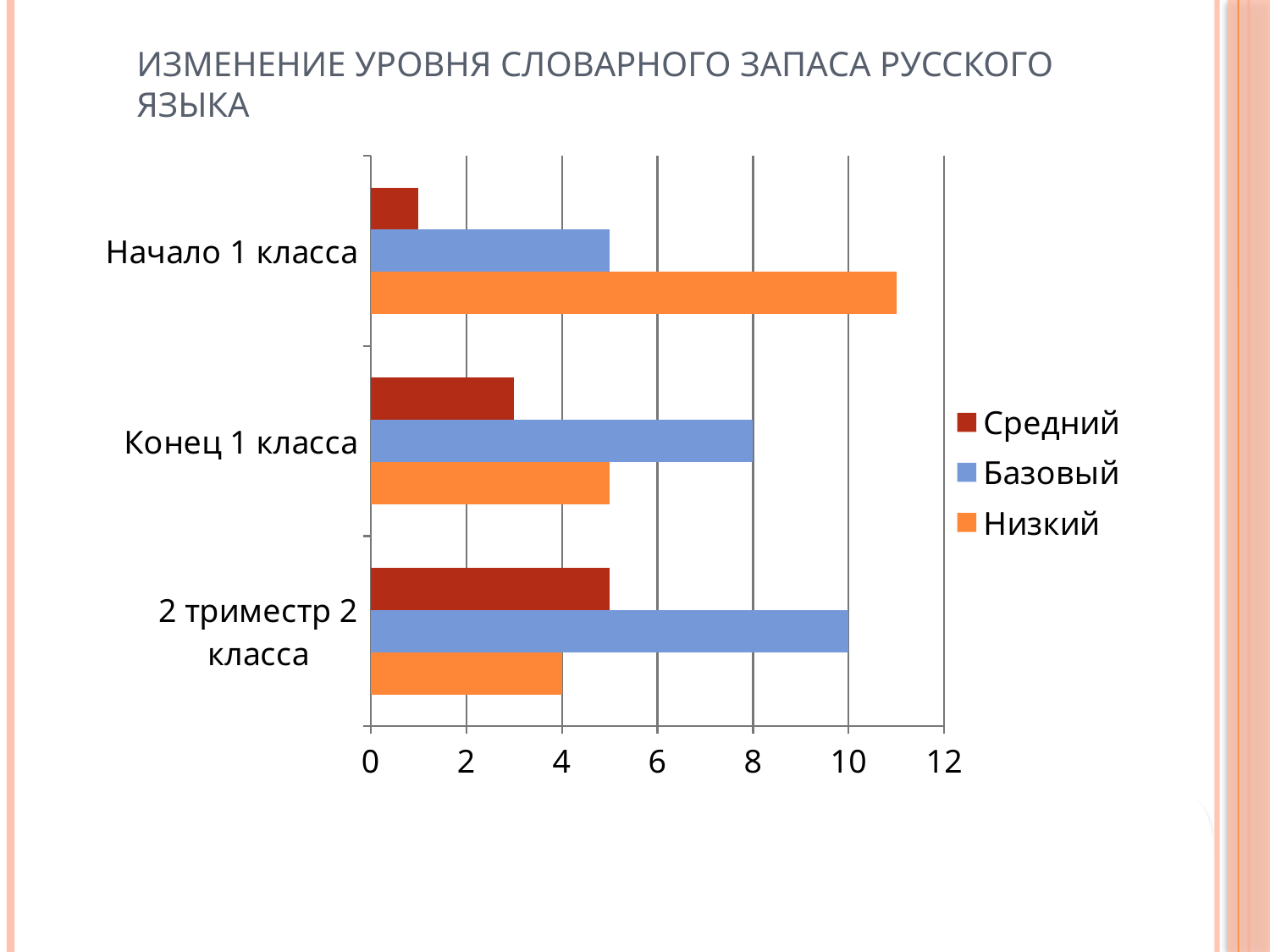
Does the Низкий series rise or fall from Начало 1 класса to 2 триместр 2 класса? fall How many series does the legend list? 3 What is the value of Базовый for 2 триместр 2 класса? 10 How many categories are shown on the chart? 3 What kind of chart is shown on the slide? bar chart Is the value of Низкий for Начало 1 класса greater or less than 10? greater What is the difference between Базовый and Низкий for 2 триместр 2 класса? 6 Which series has the lowest value for Конец 1 класса? Средний Which series has the highest value for Начало 1 класса? Низкий What is the value of Базовый for Конец 1 класса? 8 What is the value of Низкий for 2 триместр 2 класса? 4 Is the value of Средний for Начало 1 класса greater or less than 2? less